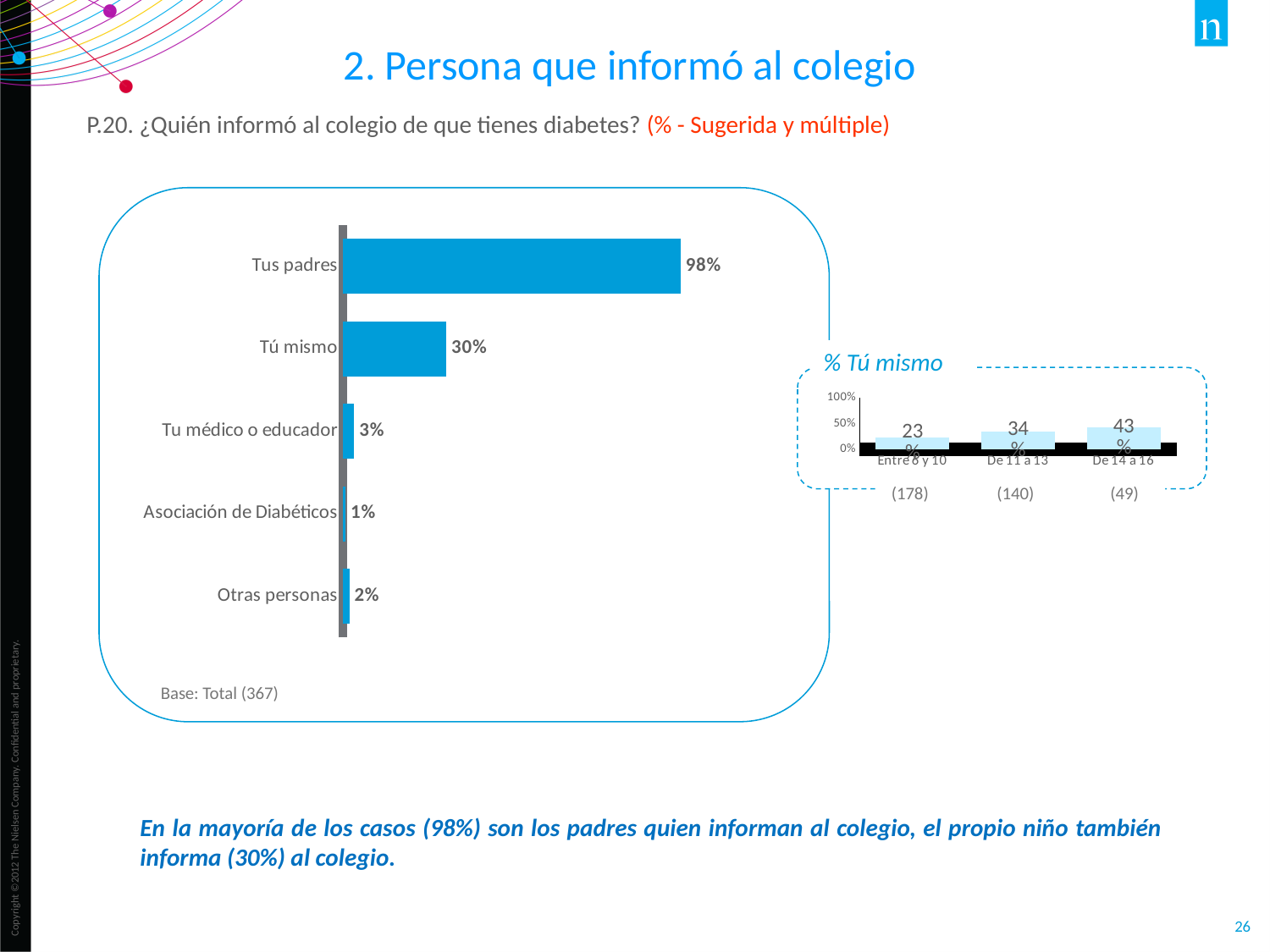
How many categories are shown in the main bar chart on the left? 5 In the "% Tú mismo" chart on the right, what is the value for "De 14 a 16"? 43% In the main bar chart on the left, which is larger: the value for "Otras personas" or the value for "Asociación de Diabéticos"? Otras personas In the main bar chart on the left, which category has the highest value? Tus padres In the "% Tú mismo" chart on the right, do the values rise or fall from the youngest to the oldest age group? Rise In the main bar chart on the left, what is the value for "Tú mismo"? 30% In the main bar chart on the left, what is the value for "Tus padres"? 98% In the main bar chart on the left, what is the value for "Tu médico o educador"? 3% In the "% Tú mismo" chart on the right, what is the difference between the values for "De 11 a 13" and "Entre 8 y 10"? 11% In the main bar chart on the left, what is the difference between the values for "Tus padres" and "Tú mismo"? 68% In the main bar chart on the left, which category has the lowest value? Asociación de Diabéticos What kind of chart is the main chart on the left? Bar chart